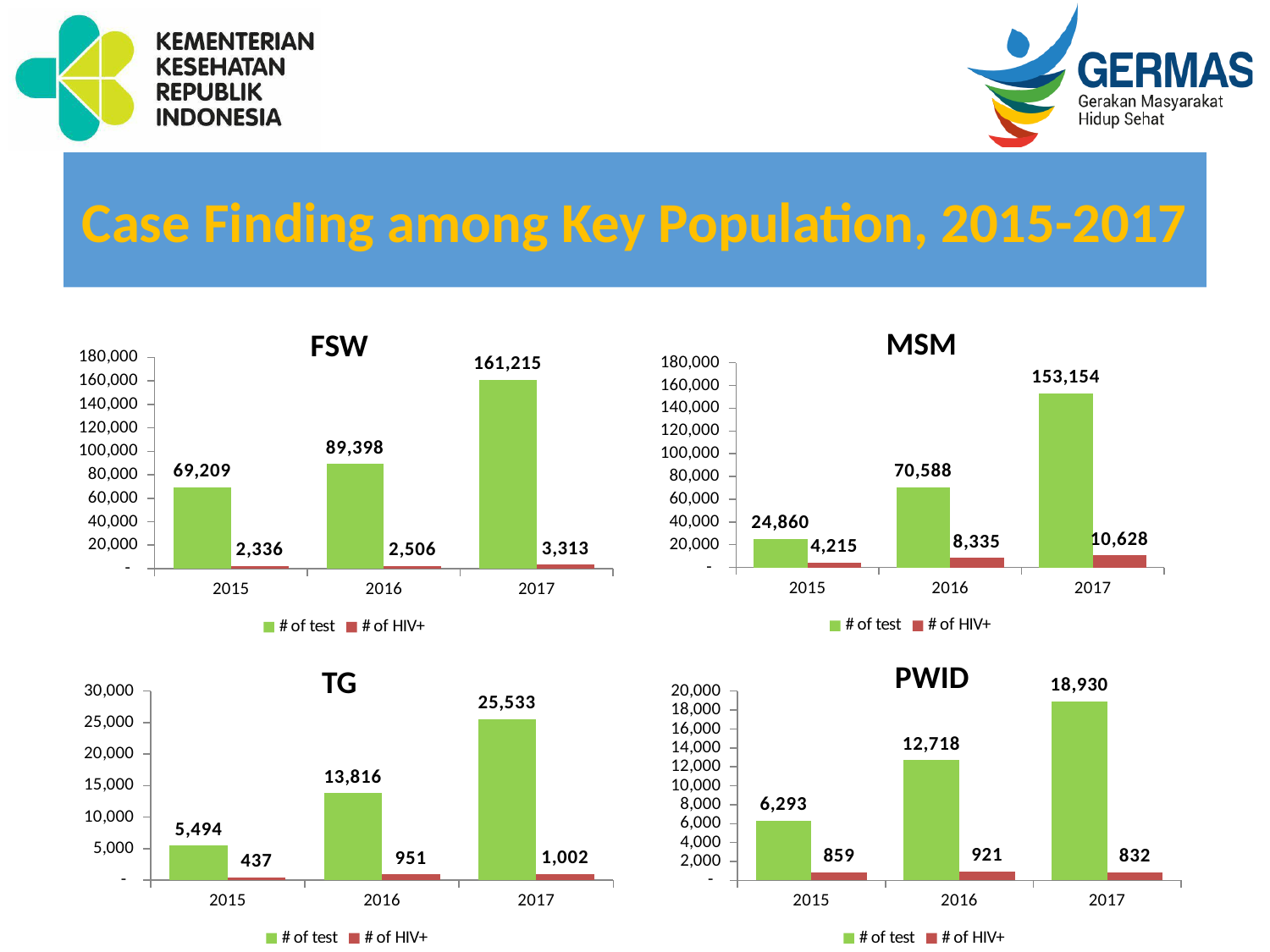
In the TG chart, which is larger: the number of tests in 2016 or the number of tests in 2015? 2016 In the TG chart, what is the number of HIV+ in 2015? 437 In the FSW chart, does the number of tests rise or fall from 2015 to 2017? Rise In the MSM chart, what is the number of HIV+ in 2016? 8,335 In the PWID chart, which year has the lowest number of tests? 2015 What type of chart is the PWID chart? Bar chart In the MSM chart, what is the difference in the number of tests between 2017 and 2016? 82,566 In the PWID chart, which year has the highest number of HIV+? 2016 In the FSW chart, what is the number of tests in 2017? 161,215 How many series does the legend of the MSM chart list? 2 In the FSW chart, is the number of tests in 2016 greater or less than 80,000? greater How many years are shown on the x axis of the FSW chart? 3